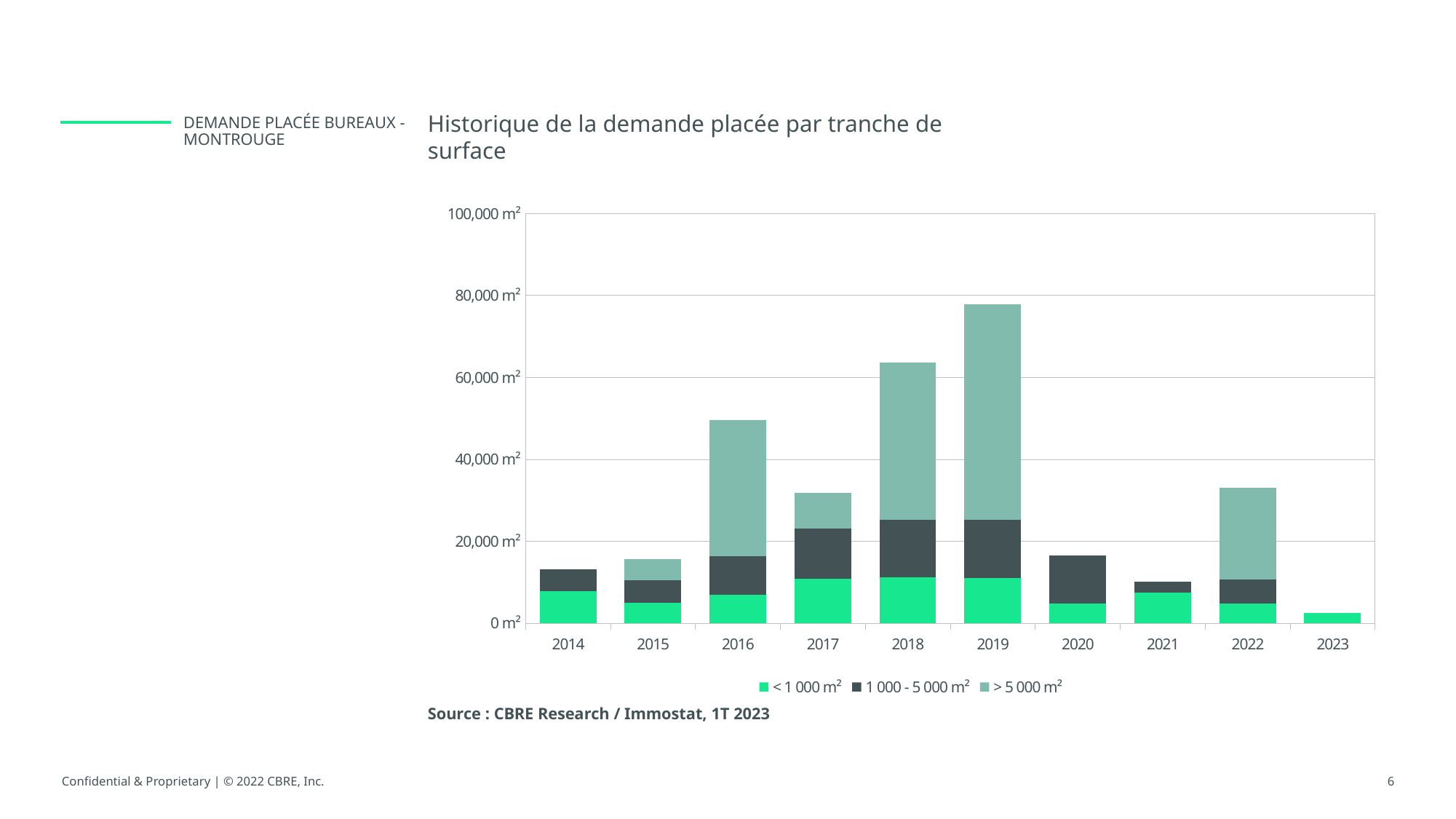
What is the title of the chart? Historique de la demande placée par tranche de surface Which year has the lowest total demande placée? 2023 Is the total value for 2023 greater or less than 20,000 m²? less Which year has the larger total, 2018 or 2016? 2018 How many years are shown on the x axis? 10 What kind of chart is shown on the slide? Stacked bar chart Is the total value for 2019 greater or less than 60,000 m²? greater Is the total value for 2021 greater or less than 20,000 m²? less How many series does the legend list? 3 Which year has the larger total, 2020 or 2021? 2020 Which year has the highest total demande placée? 2019